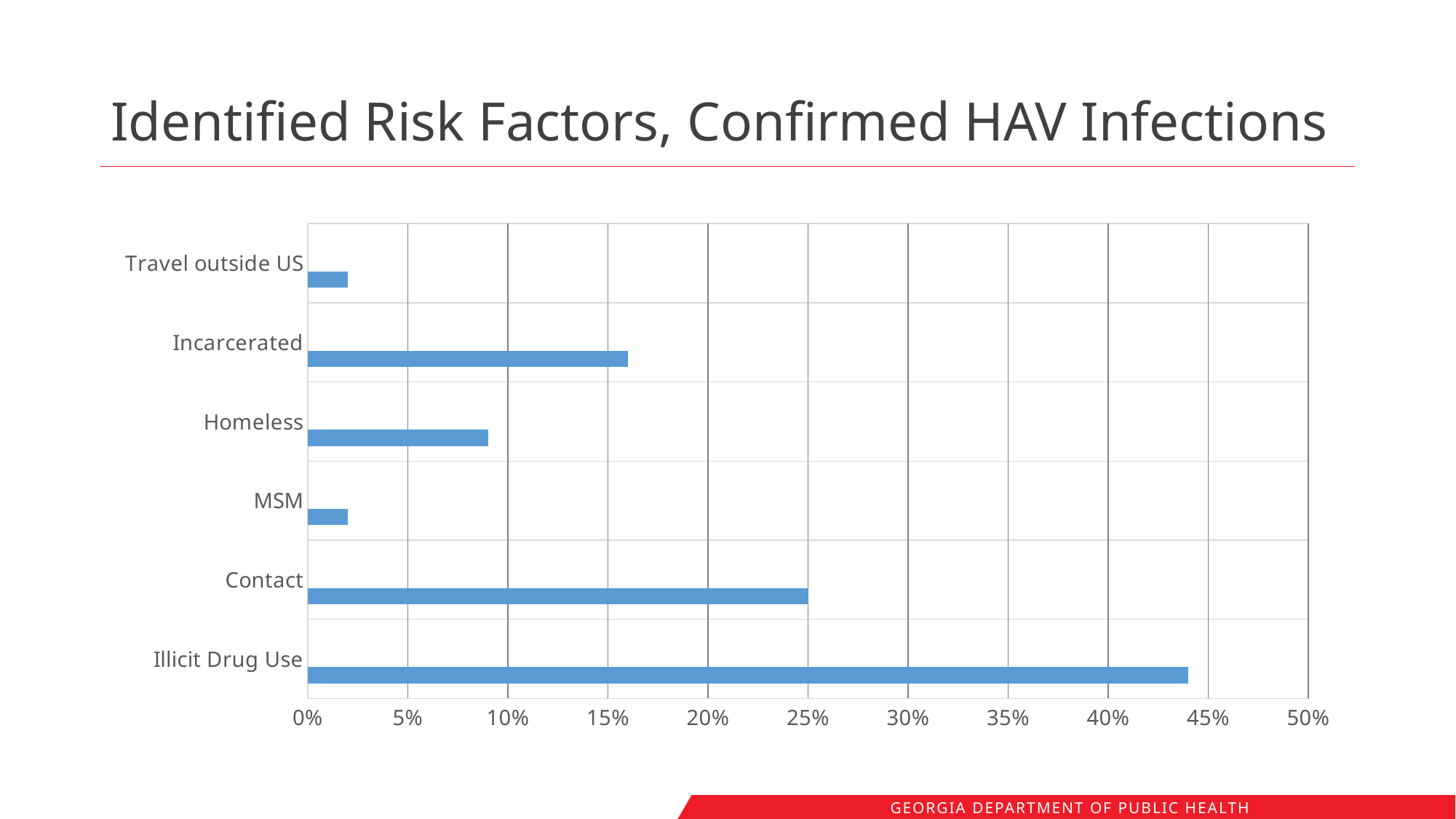
Is the value for Incarcerated greater or less than 15%? greater Is the value for Illicit Drug Use greater or less than 40%? greater Which is larger, the value for Incarcerated or the value for Homeless? Incarcerated Is the value for Travel outside US greater or less than 5%? less What is the value for Contact? 25% Which is larger, the value for Contact or the value for Incarcerated? Contact How many risk factor categories are plotted in the chart? 6 What is the title of the chart? Identified Risk Factors, Confirmed HAV Infections What kind of chart is shown on the slide? bar chart Which risk factor has the highest percentage? Illicit Drug Use